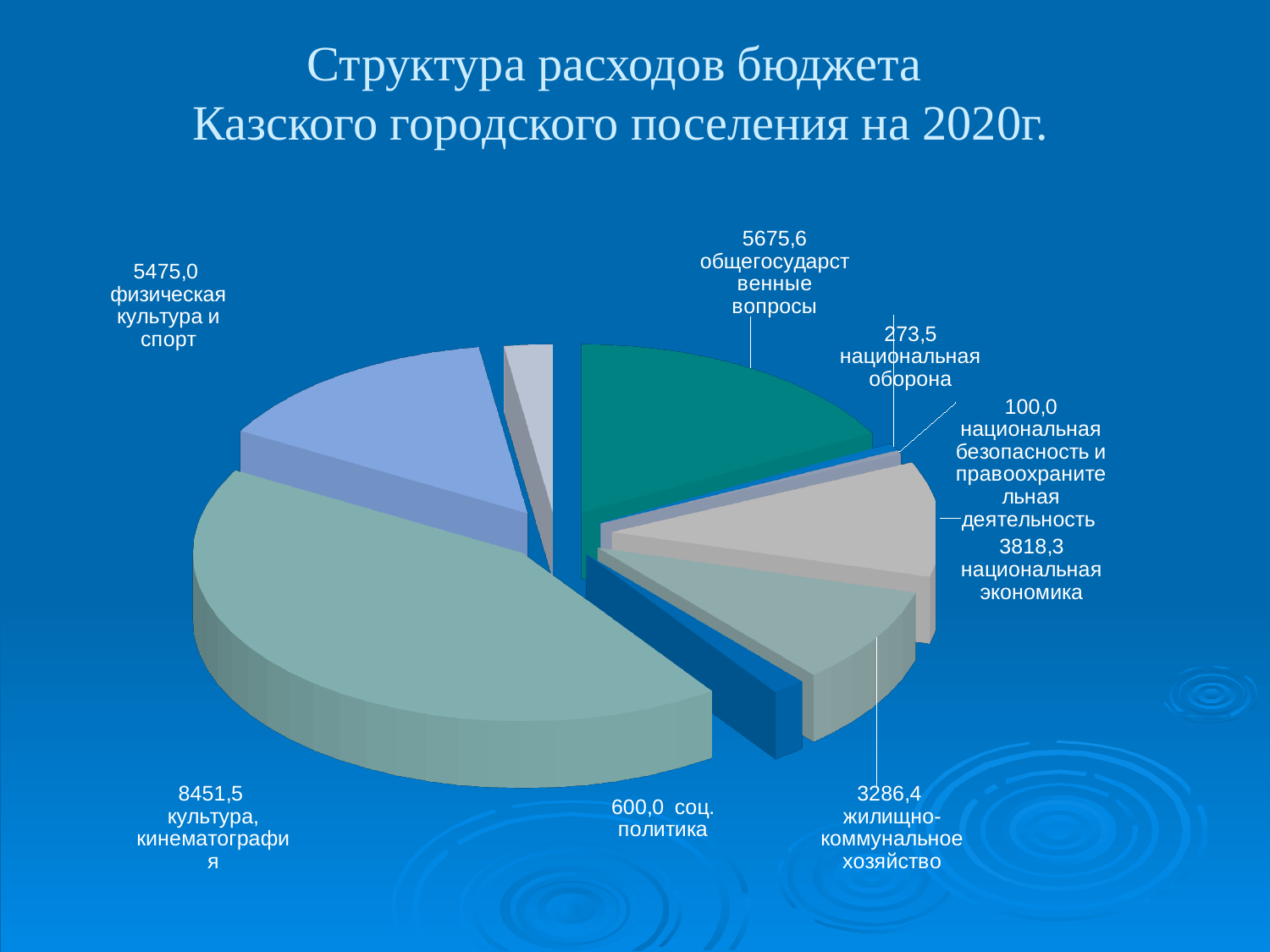
What is the difference between культура, кинематография and общегосударственные вопросы? 2775,9 Which is larger: физическая культура и спорт or национальная экономика? физическая культура и спорт What is the value for национальная оборона? 273,5 Which category has the smallest value? национальная безопасность и правоохранительная деятельность What is the value for соц. политика? 600,0 What is the value for общегосударственные вопросы? 5675,6 What kind of chart is shown on the slide? pie chart Which category has the largest value? культура, кинематография What is the value for жилищно-коммунальное хозяйство? 3286,4 What is the difference between национальная экономика and жилищно-коммунальное хозяйство? 531,9 What is the title of the slide? Структура расходов бюджета Казского городского поселения на 2020г.